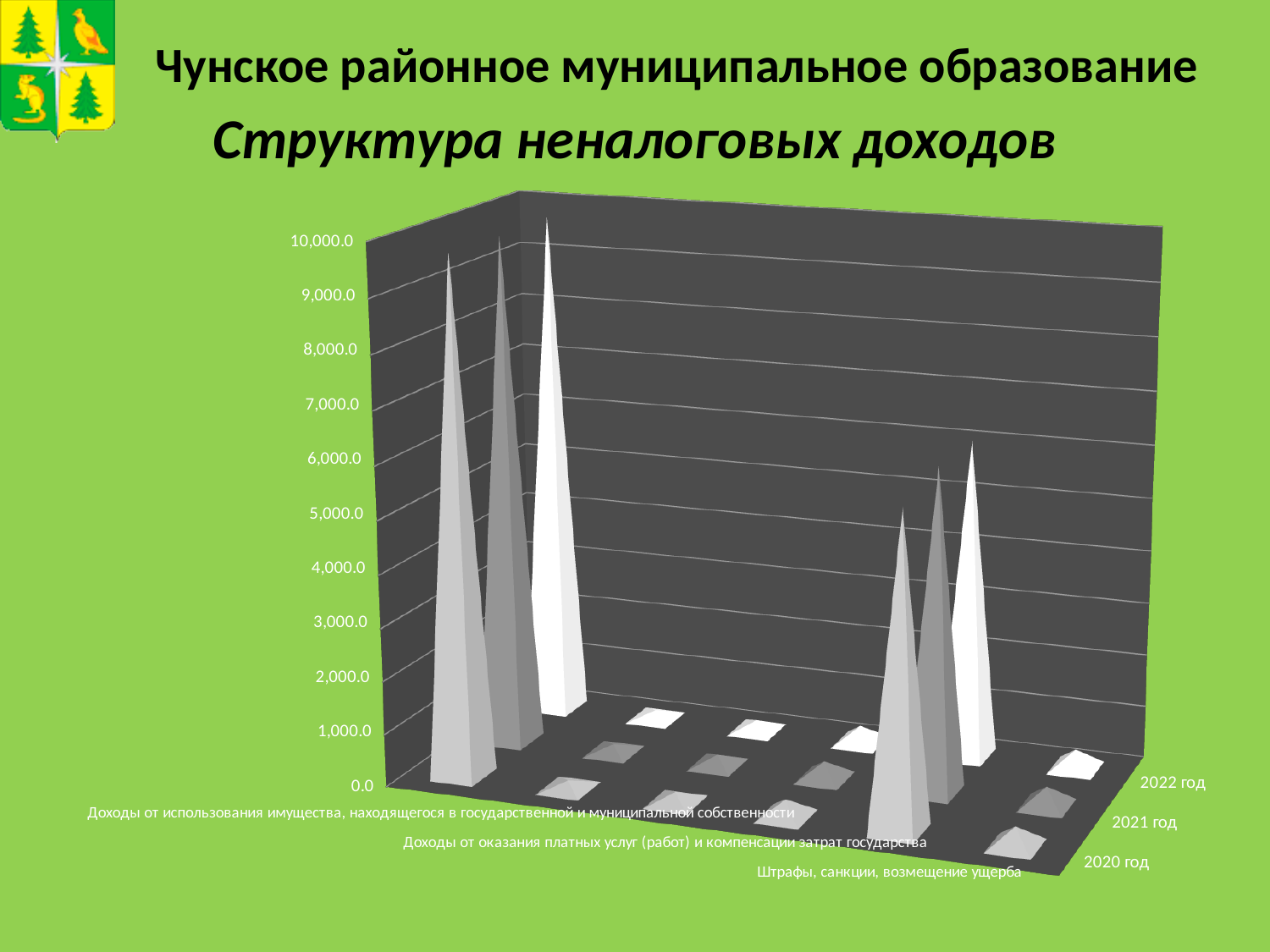
Which is larger in 2021 год: 'Доходы от использования имущества, находящегося в государственной и муниципальной собственности' or 'Штрафы, санкции, возмещение ущерба'? Доходы от использования имущества, находящегося в государственной и муниципальной собственности What is the highest value shown on the vertical axis of the chart? 10,000.0 What kind of chart is shown on the slide? bar chart Which year is shown at the front of the depth axis of the chart? 2020 год Is the value for 'Доходы от использования имущества, находящегося в государственной и муниципальной собственности' in 2020 год greater or less than 5,000.0? greater How many years (series) are plotted on the depth axis of the chart? 3 Is the value for 'Доходы от использования имущества, находящегося в государственной и муниципальной собственности' in 2022 год greater or less than 5,000.0? greater What is the title of the chart on the slide? Структура неналоговых доходов Is the value for 'Штрафы, санкции, возмещение ущерба' in 2020 год greater or less than 1,000.0? greater